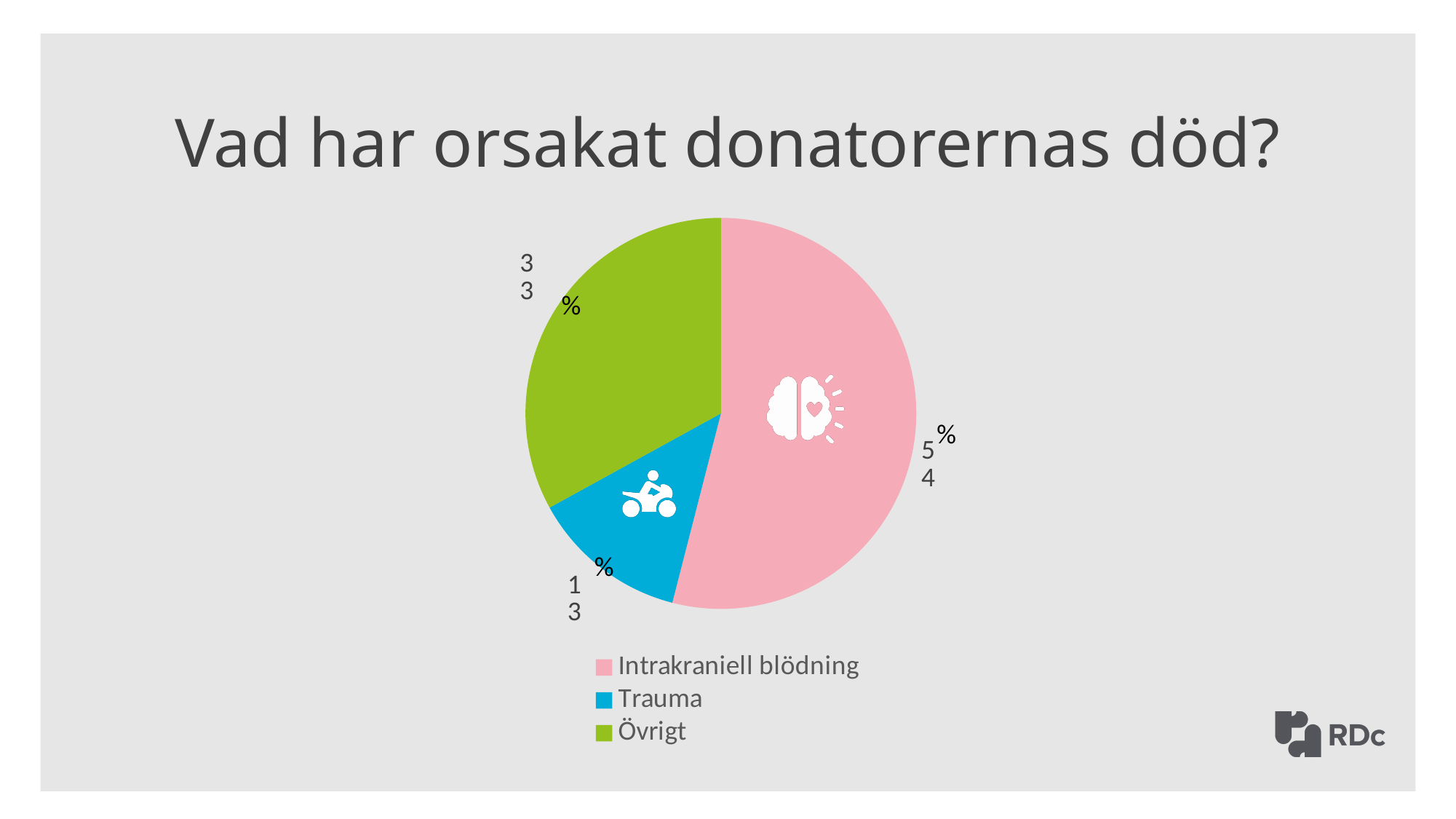
How many entries does the legend list? 3 How many slices does the pie chart have? 3 What is the difference in percentage points between Intrakraniell blödning and Övrigt? 21 What kind of chart is shown on the slide? pie chart What share of the pie is Övrigt? 33% Which category has the smallest share of the pie? Trauma What is the title of the chart? Vad har orsakat donatorernas död? Which category has the largest share of the pie? Intrakraniell blödning What share of the pie is Intrakraniell blödning? 54% Which colour represents Trauma in the pie chart? blue What share of the pie is Trauma? 13% Which is larger, the share for Övrigt or the share for Trauma? Övrigt